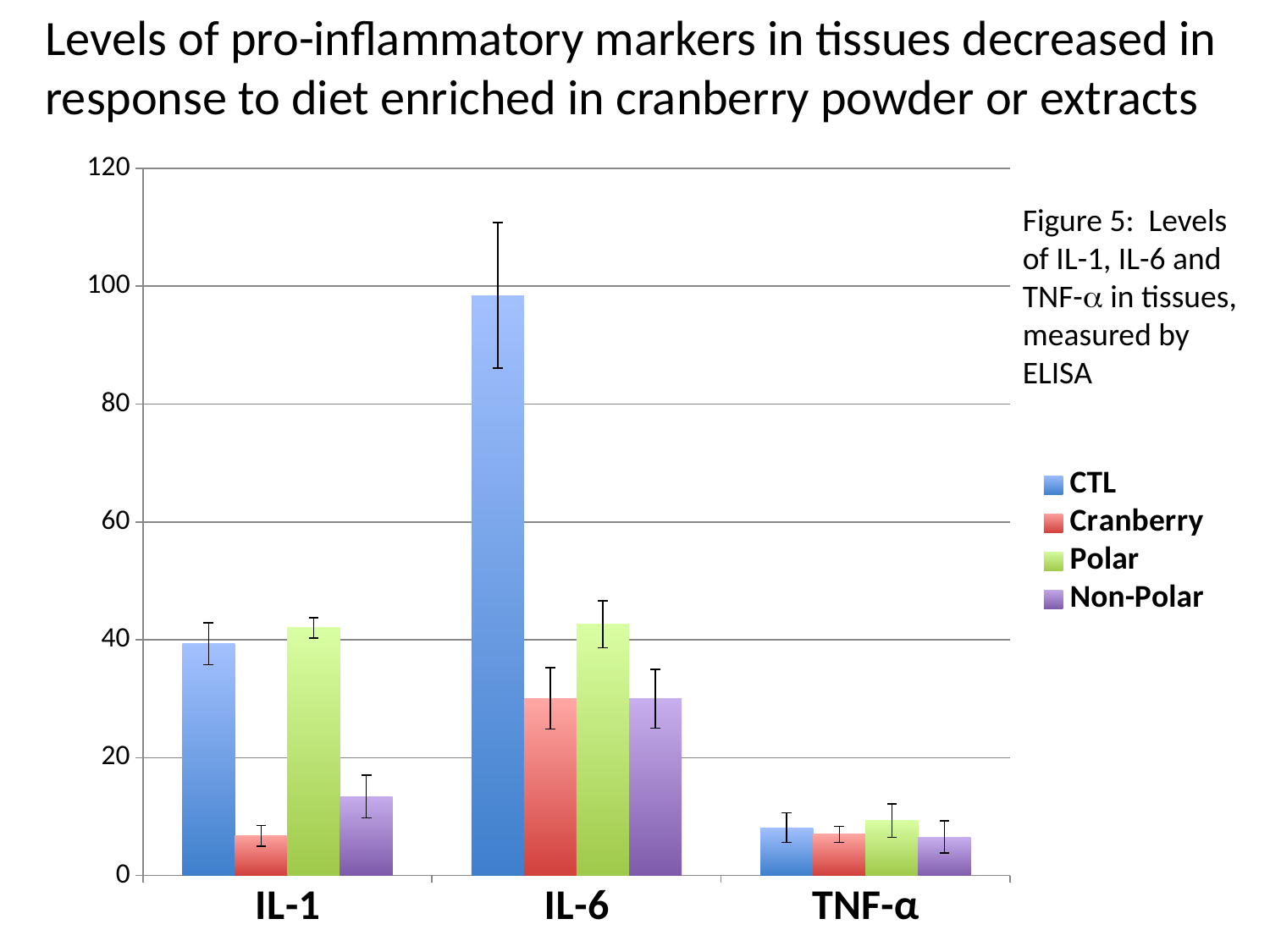
Within the IL-1 group, which series has the lowest bar? Cranberry How many categories are shown on the x axis? 3 For IL-6, which is larger: the Polar value or the Cranberry value? Polar How many series does the legend list? 4 Is the CTL value for IL-6 greater or less than 80? greater Is the Non-Polar value for IL-6 greater or less than 40? less For which category is the CTL bar the highest? IL-6 What are the four series listed in the legend? CTL, Cranberry, Polar, Non-Polar What colour are the CTL bars? blue For IL-1, which is larger: the CTL value or the Non-Polar value? CTL What kind of chart is shown on the slide? bar chart Is the Cranberry value for IL-1 greater or less than 20? less